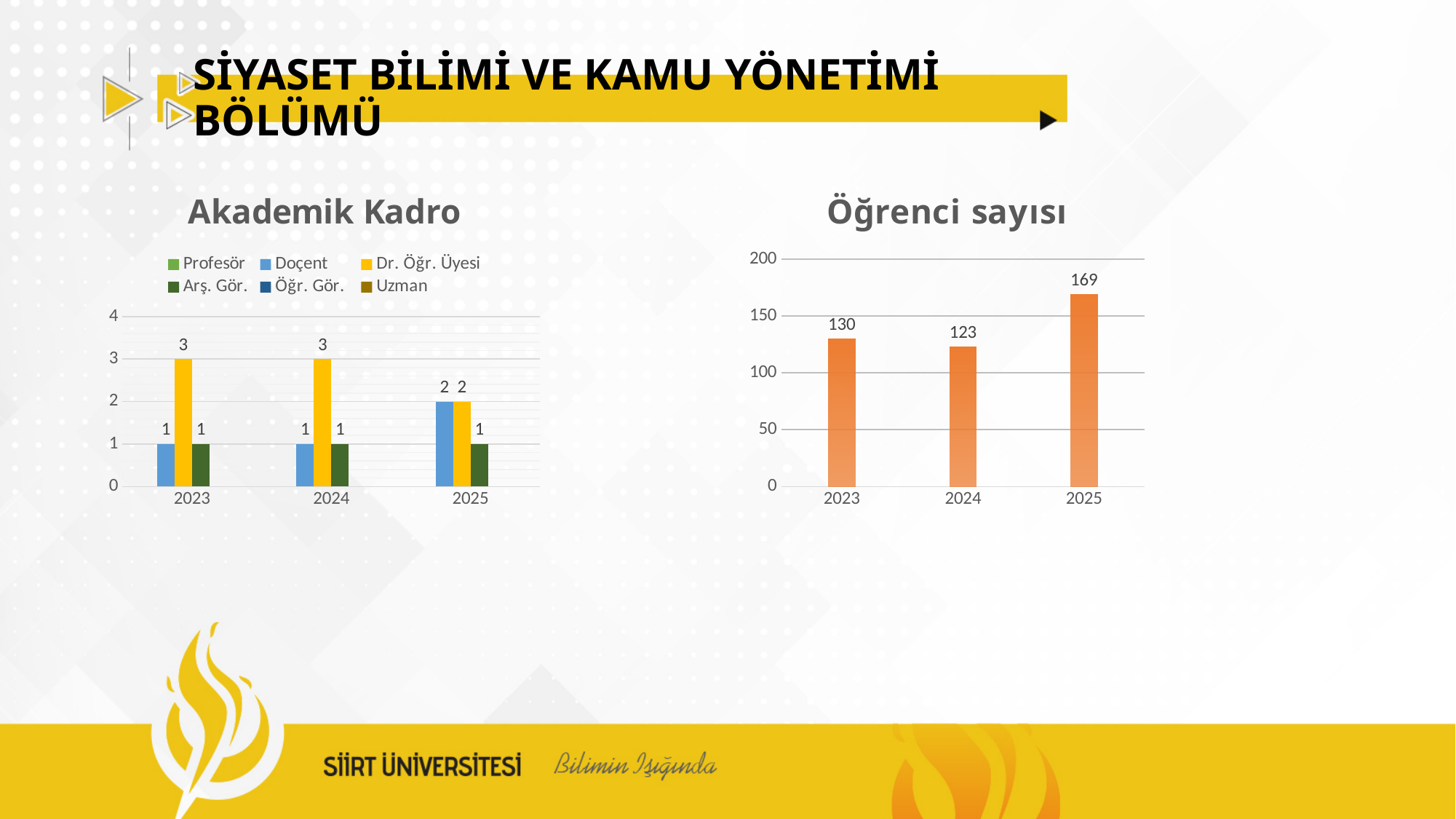
In the "Öğrenci sayısı" chart, what is the difference between the values for 2025 and 2024? 46 In the "Öğrenci sayısı" chart, what is the value for 2023? 130 In the "Akademik Kadro" chart, what is the value for Dr. Öğr. Üyesi in 2023? 3 In the "Öğrenci sayısı" chart, what is the value for 2025? 169 In the "Öğrenci sayısı" chart, which year has the lowest value? 2024 In the "Akademik Kadro" chart, what is the value for Doçent in 2025? 2 In the "Akademik Kadro" chart, how many series does the legend list? 6 In the "Öğrenci sayısı" chart, which year has the highest value? 2025 In the "Öğrenci sayısı" chart, how many years are shown on the x axis? 3 What kind of chart is the "Öğrenci sayısı" chart? bar chart In the "Akademik Kadro" chart, what colour are the Dr. Öğr. Üyesi bars? yellow In the "Akademik Kadro" chart, is the value for Dr. Öğr. Üyesi in 2024 larger or smaller than the value for Arş. Gör. in 2024? larger